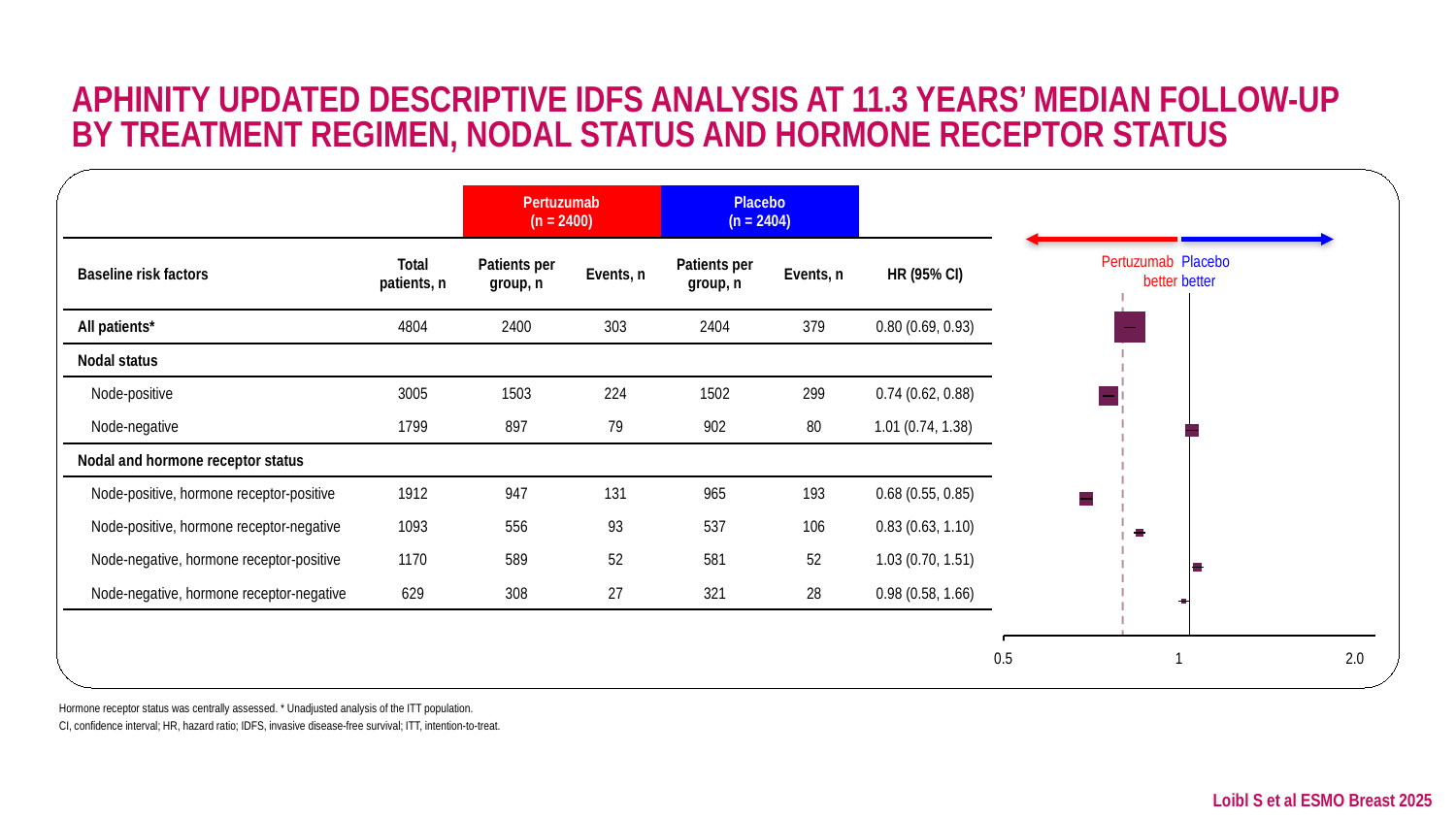
What is the HR (95% CI) for the Node-positive subgroup? 0.74 (0.62, 0.88) Is the hazard ratio for the Node-positive, hormone receptor-positive subgroup greater or less than 1? less What kind of chart is shown on the right side of the slide? Forest plot What is the difference between the highest and lowest hazard ratio point estimates shown (1.03 and 0.68)? 0.35 How many hazard ratio points are plotted in the forest plot? 7 What is the HR (95% CI) for the Node-negative, hormone receptor-negative subgroup? 0.98 (0.58, 1.66) What are the tick labels shown on the x axis of the forest plot? 0.5, 1, 2.0 Which subgroup has the highest hazard ratio point estimate in the forest plot? Node-negative, hormone receptor-positive What is the HR (95% CI) plotted for All patients in the forest plot? 0.80 (0.69, 0.93) Which treatment is labelled as 'better' on the left side of the forest plot's x axis? Pertuzumab Which has the larger hazard ratio point estimate: Node-positive or Node-negative? Node-negative Which subgroup has the lowest hazard ratio point estimate in the forest plot? Node-positive, hormone receptor-positive